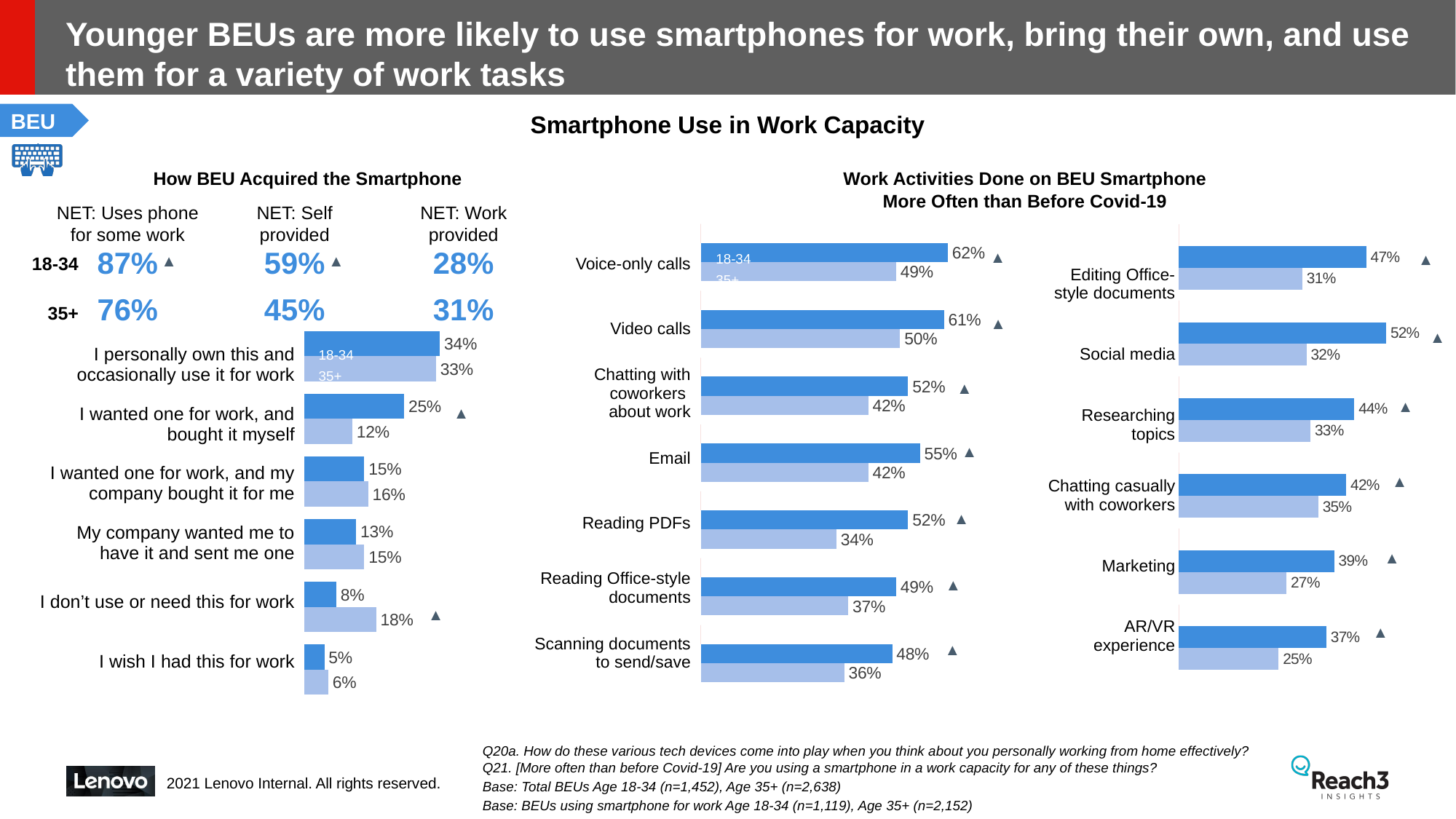
In the 'Work Activities Done on BEU Smartphone More Often than Before Covid-19' chart, which activity has the lowest value for the 35+ group? AR/VR experience In the 'How BEU Acquired the Smartphone' chart, what percentage of 18-34 BEUs say 'I wanted one for work, and bought it myself'? 25% In the 'Work Activities Done on BEU Smartphone More Often than Before Covid-19' chart, which activity has the highest value for the 18-34 group? Voice-only calls In the 'How BEU Acquired the Smartphone' chart, what is the difference between the 18-34 and 35+ values for 'I wanted one for work, and bought it myself'? 13% In the 'How BEU Acquired the Smartphone' chart, which category has the highest value for the 18-34 group? I personally own this and occasionally use it for work In the 'How BEU Acquired the Smartphone' chart, what percentage of 35+ BEUs say 'I don't use or need this for work'? 18% In the 'Work Activities Done on BEU Smartphone More Often than Before Covid-19' chart, what is the difference between the 18-34 and 35+ values for Social media? 20% What type of chart is used for 'How BEU Acquired the Smartphone'? Bar chart In the 'How BEU Acquired the Smartphone' chart, which category has the lowest value for the 35+ group? I wish I had this for work In the 'Work Activities Done on BEU Smartphone More Often than Before Covid-19' chart, what percentage of 35+ BEUs use their smartphone for reading PDFs? 34% In the 'Work Activities Done on BEU Smartphone More Often than Before Covid-19' chart, which is larger for the 18-34 group: Social media or Email? Email In the 'Work Activities Done on BEU Smartphone More Often than Before Covid-19' chart, what percentage of 18-34 BEUs use their smartphone for voice-only calls? 62%